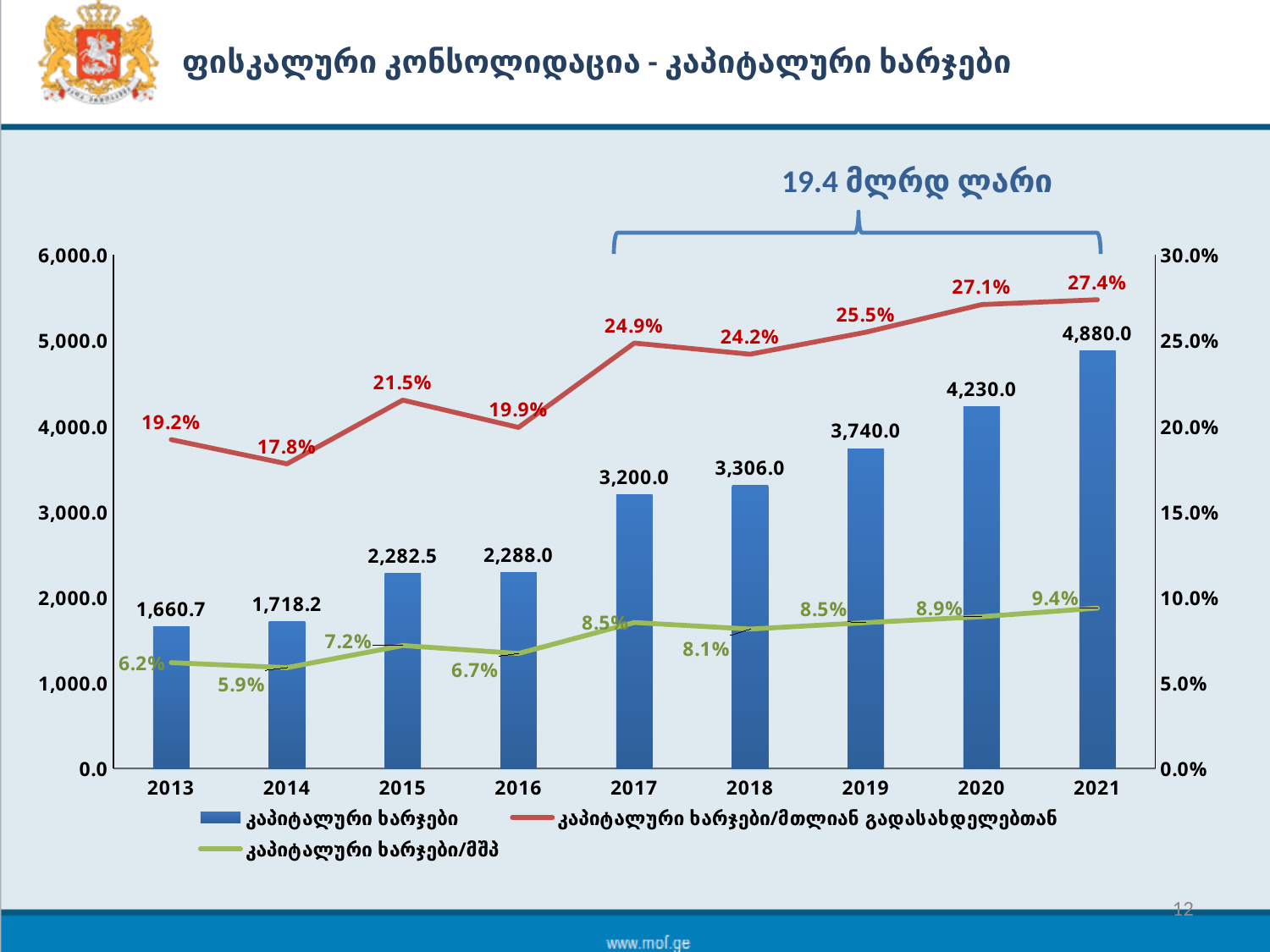
What is the value of the კაპიტალური ხარჯები bar for 2021? 4,880.0 What is the value of the კაპიტალური ხარჯები/მშპ line in 2018? 8.1% Is the კაპიტალური ხარჯები bar for 2019 greater or less than 3,000.0? greater What is the difference between the კაპიტალური ხარჯები bars for 2021 and 2020? 650.0 What is the value of the კაპიტალური ხარჯები/მთლიან გადასახდელებთან line in 2015? 21.5% How many years are shown on the x axis of the chart? 9 What is the value of the კაპიტალური ხარჯები bar for 2013? 1,660.7 In which year is the კაპიტალური ხარჯები bar the highest? 2021 Which year has a larger კაპიტალური ხარჯები/მშპ value, 2017 or 2018? 2017 In which year is the კაპიტალური ხარჯები/მთლიან გადასახდელებთან line at its lowest? 2014 Does the კაპიტალური ხარჯები/მშპ line generally rise or fall from 2013 to 2021? rise How many series does the legend list? 3